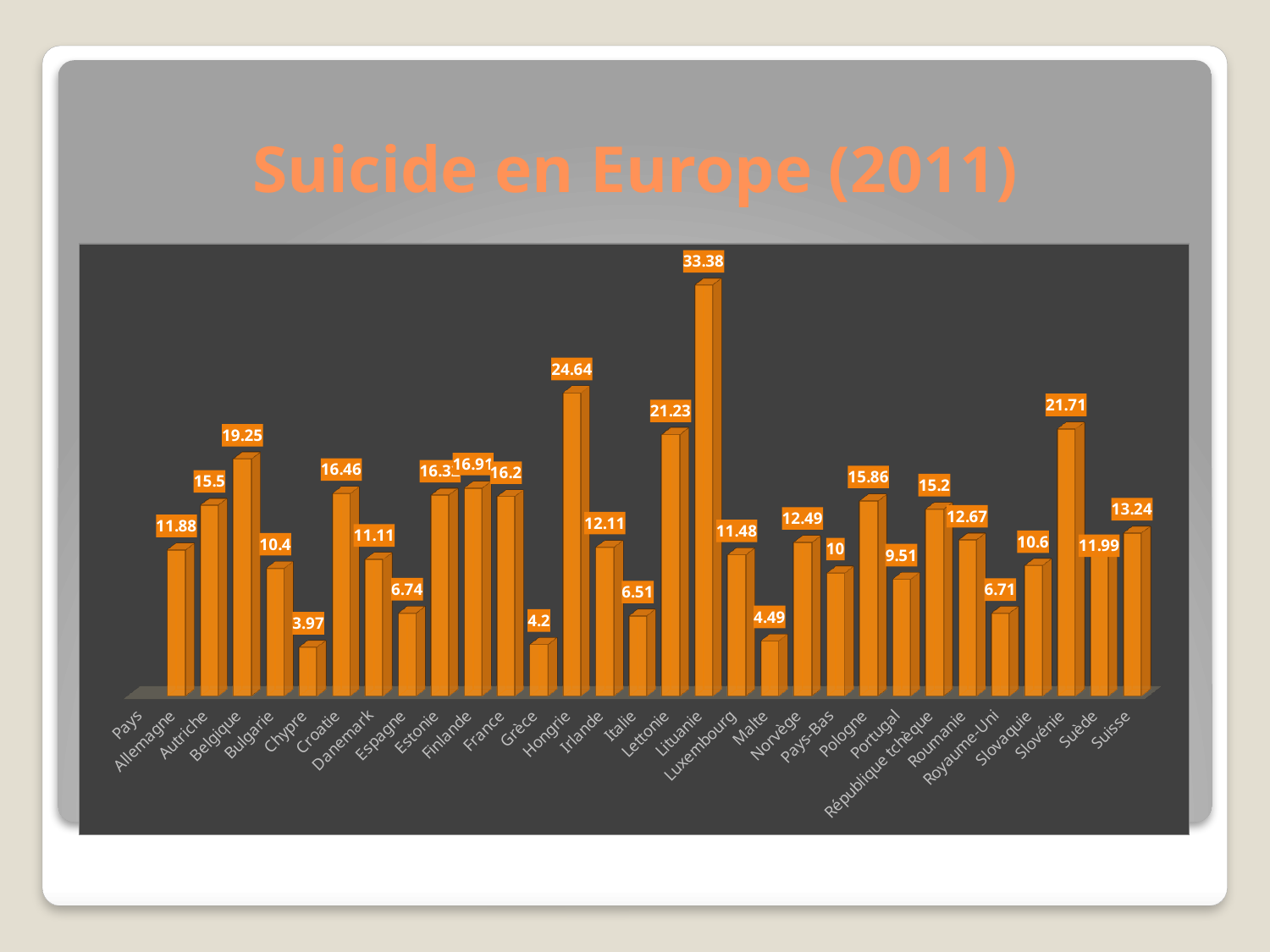
How many countries have a bar plotted in the chart? 29 What is the difference between the values for Lituanie and Hongrie? 8.74 Which country has the highest value in the chart? Lituanie What is the value shown for Hongrie? 24.64 What is the difference between the values for Belgique and Allemagne? 7.37 What type of chart is shown on the slide? Bar chart Which has a larger value, Hongrie or Slovénie? Hongrie Which country has the lowest value in the chart? Chypre What is the value shown for Lituanie? 33.38 Which has a larger value, Pologne or Norvège? Pologne What is the value shown for Pays-Bas? 10 What is the value shown for République tchèque? 15.2